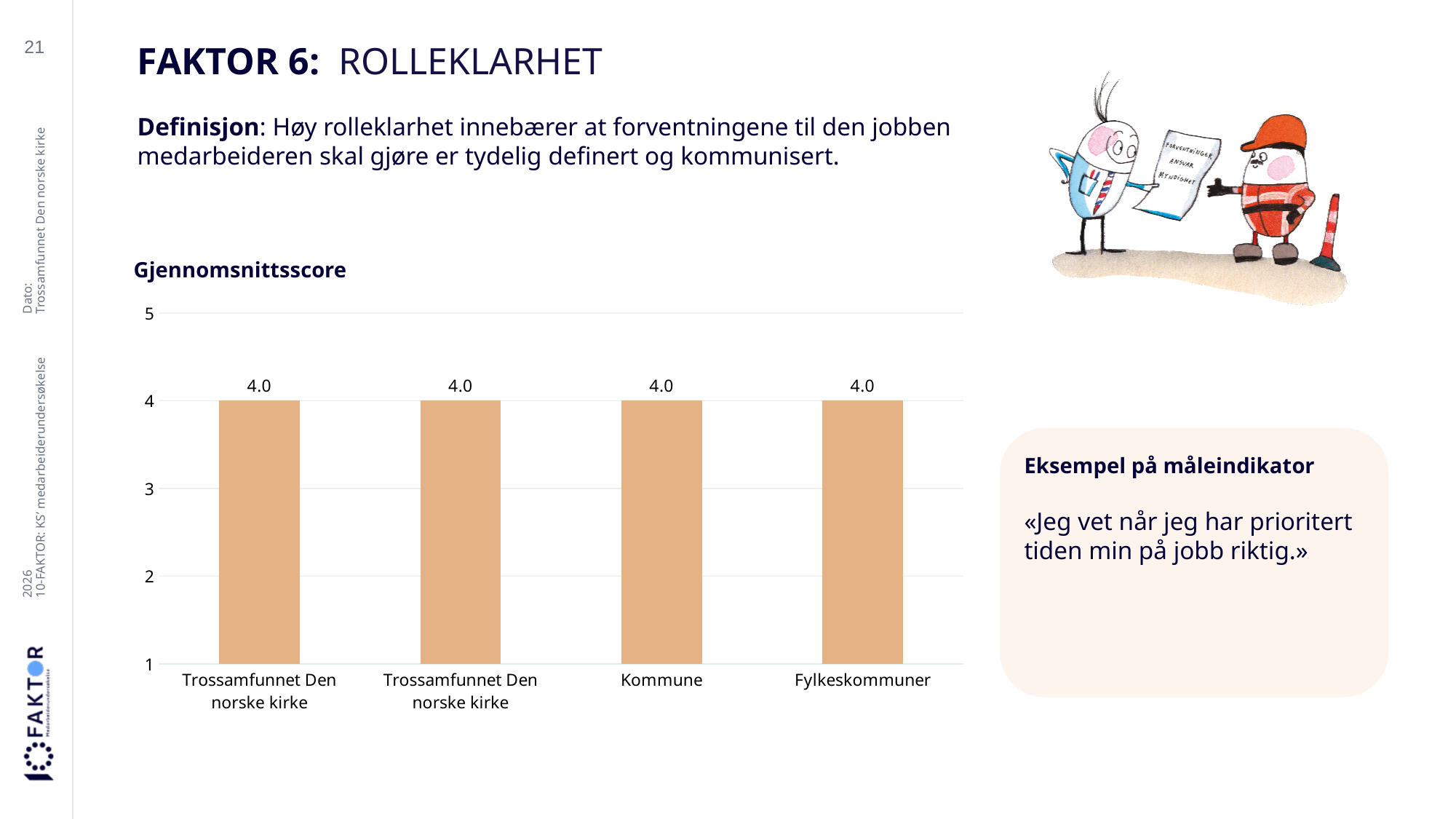
How many bars are shown in the chart? 4 What is the value for Fylkeskommuner? 4.0 What kind of chart is shown on the slide? bar chart Is the value for Fylkeskommuner greater or less than 5? less What is the value for Trossamfunnet Den norske kirke? 4.0 What is the difference between the values for Kommune and Fylkeskommuner? 0.0 What is the title of the chart? Gjennomsnittsscore What is the value for Kommune? 4.0 What is the highest value shown on the vertical axis? 5 Do the values rise, fall or stay the same across the categories from left to right? stay the same Is the value for Kommune greater or less than 3? greater